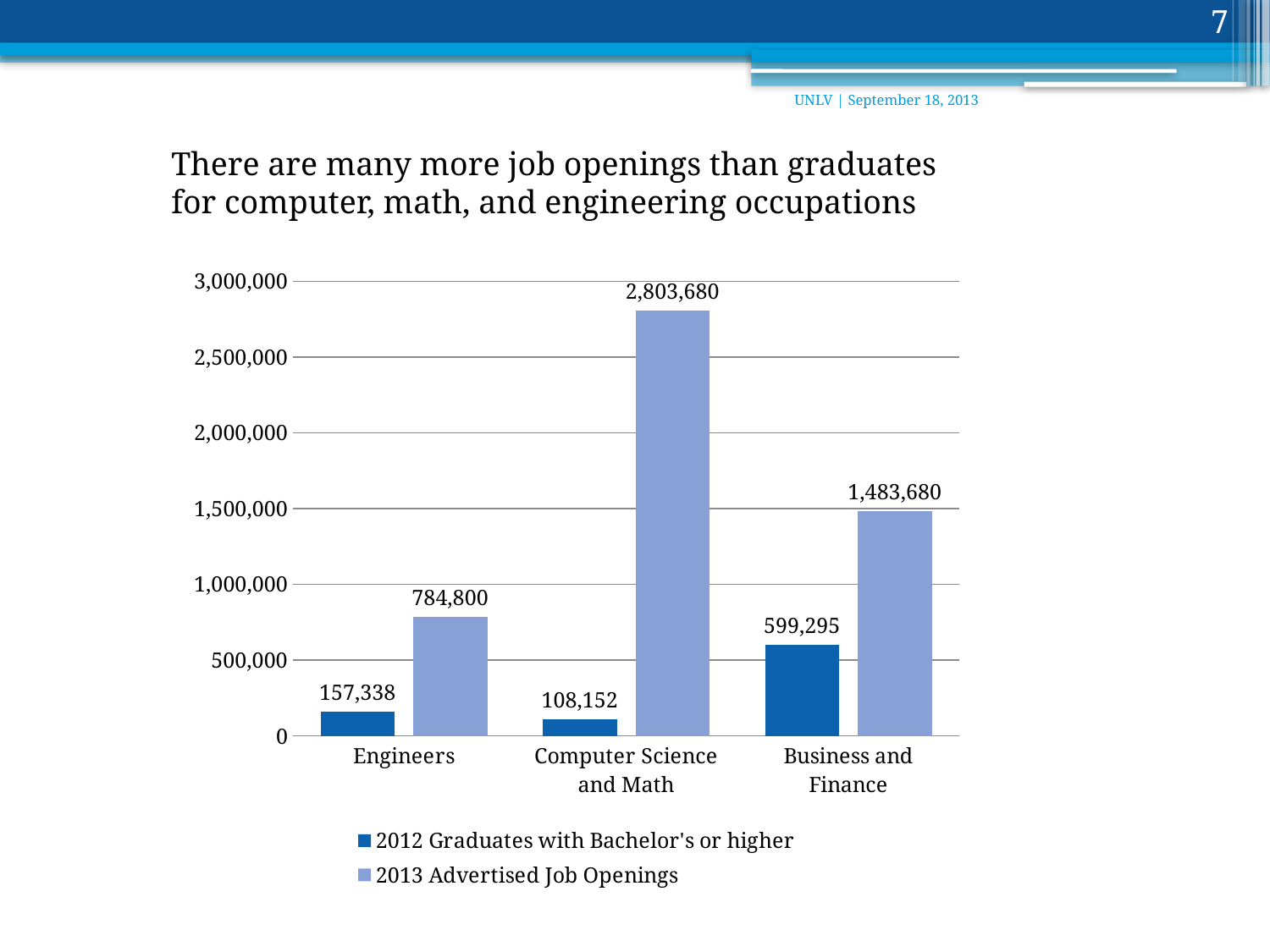
What is the value for 2012 Graduates with Bachelor's or higher for Engineers? 157,338 How many series does the legend list? 2 What is the difference between 2013 Advertised Job Openings and 2012 Graduates with Bachelor's or higher for Engineers? 627,462 Which category has the lowest value for 2012 Graduates with Bachelor's or higher? Computer Science and Math Which category has the highest value for 2013 Advertised Job Openings? Computer Science and Math What is the value for 2013 Advertised Job Openings for Computer Science and Math? 2,803,680 Which is larger: 2012 Graduates with Bachelor's or higher for Business and Finance or for Engineers? Business and Finance How many categories are shown on the x axis? 3 What is the value for 2012 Graduates with Bachelor's or higher for Business and Finance? 599,295 What is the value for 2013 Advertised Job Openings for Engineers? 784,800 What is the difference between 2013 Advertised Job Openings and 2012 Graduates with Bachelor's or higher for Computer Science and Math? 2,695,528 What kind of chart is shown on the slide? Bar chart